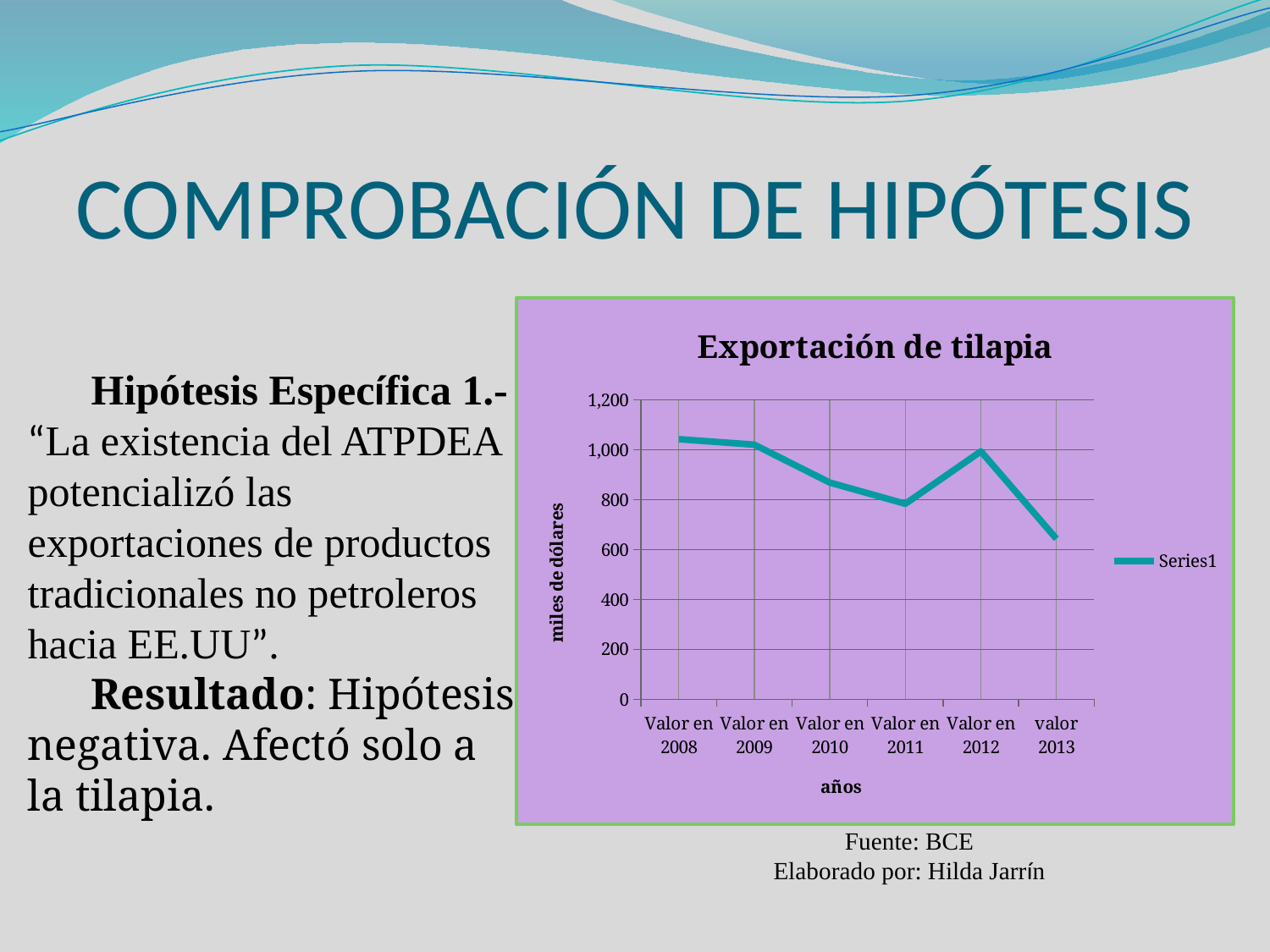
How many data points are plotted on the line? 6 Is the value for 2010 greater or less than 800? greater Overall, do the values rise or fall from 2008 to 2013? fall How many series does the legend list? 1 Which year has the lowest value for tilapia exports? 2013 Is the value for 2008 greater or less than 1,000? greater What kind of chart is shown on the slide? line chart Which is larger, the value for 2010 or the value for 2011? 2010 What is the title of the chart? Exportación de tilapia Is the value for 2013 greater or less than 800? less What is the label of the vertical axis of the chart? miles de dólares Which is larger, the value for 2012 or the value for 2013? 2012